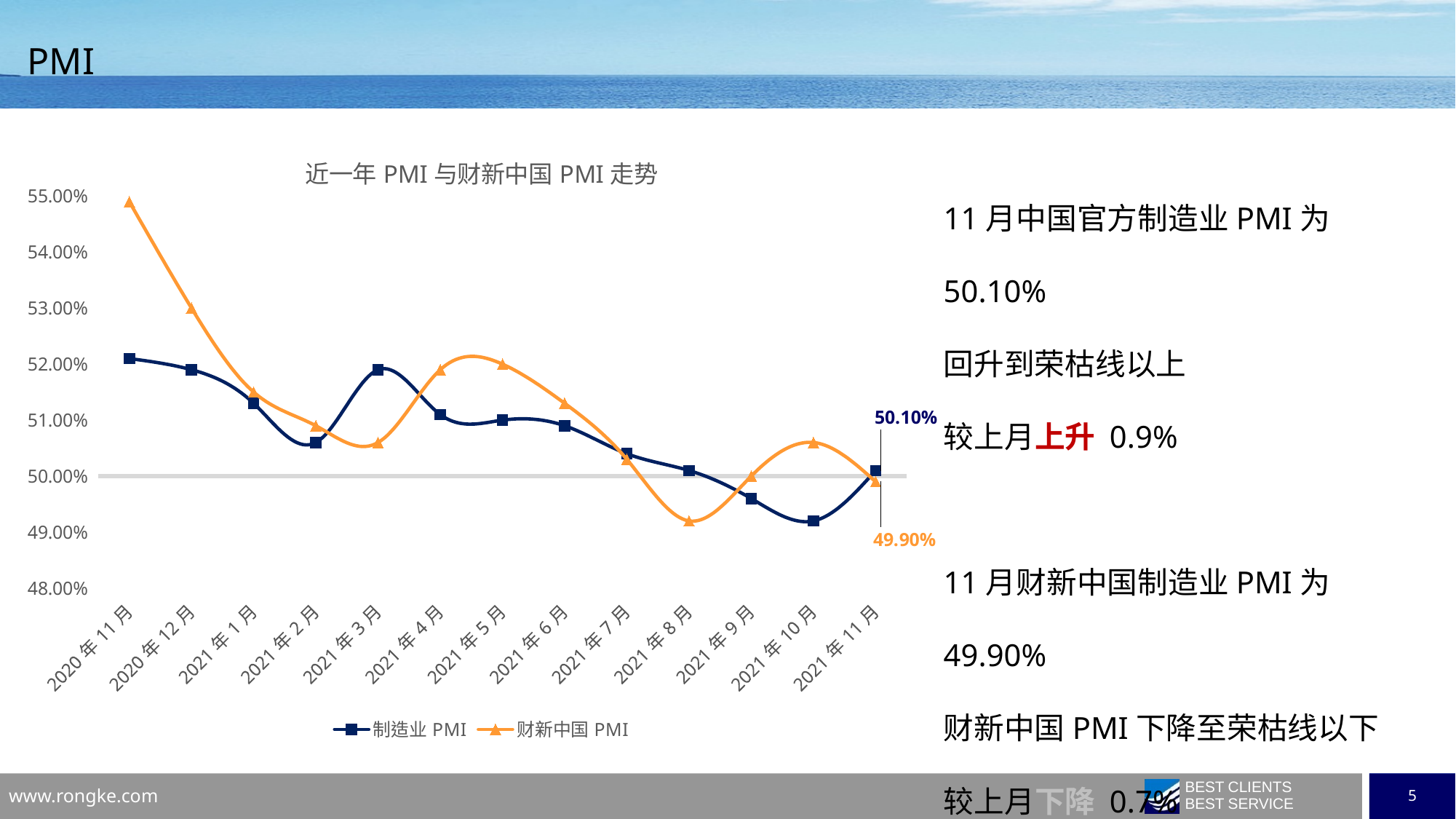
What is the difference between 制造业 PMI and 财新中国 PMI for 2021年11月? 0.20% How many series does the chart legend list? 2 What is the value of 制造业 PMI for 2021年11月? 50.10% In which month is 制造业 PMI at its lowest? 2021年10月 What is the title of the chart? 近一年 PMI 与财新中国 PMI 走势 In which month is 财新中国 PMI at its highest? 2020年11月 How many months are plotted along the x axis of the chart? 13 For 2021年11月, which series has the higher value, 制造业 PMI or 财新中国 PMI? 制造业 PMI Is the value of 制造业 PMI for 2021年10月 greater or less than 50.00%? less Is the value of 财新中国 PMI for 2020年11月 greater or less than 54.00%? greater What kind of chart is shown on the slide? line chart What is the value of 财新中国 PMI for 2021年11月? 49.90%